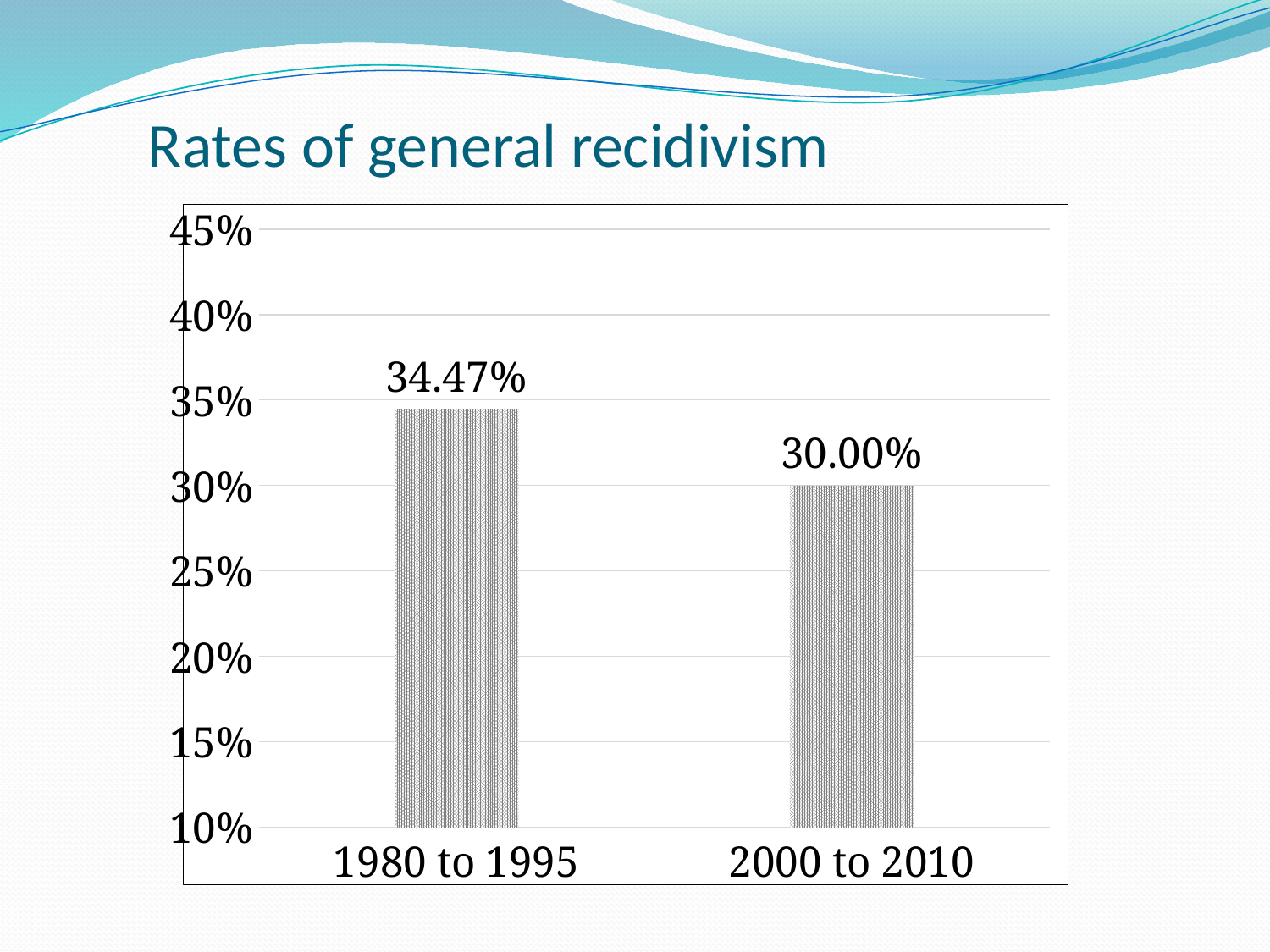
Do the recidivism rates rise or fall from 1980 to 1995 to 2000 to 2010? Fall Which is larger, the rate for 1980 to 1995 or the rate for 2000 to 2010? 1980 to 1995 What is the difference between the recidivism rates for 1980 to 1995 and 2000 to 2010? 4.47% Is the value for 2000 to 2010 greater or less than 25%? greater What is the title of the slide? Rates of general recidivism Is the value for 1980 to 1995 greater or less than 35%? less What is the rate of general recidivism for 1980 to 1995? 34.47% What is the rate of general recidivism for 2000 to 2010? 30.00% Which period has the lowest rate of general recidivism? 2000 to 2010 What kind of chart is shown on the slide? Bar chart Which period has the highest rate of general recidivism? 1980 to 1995 How many periods are shown in the chart? 2